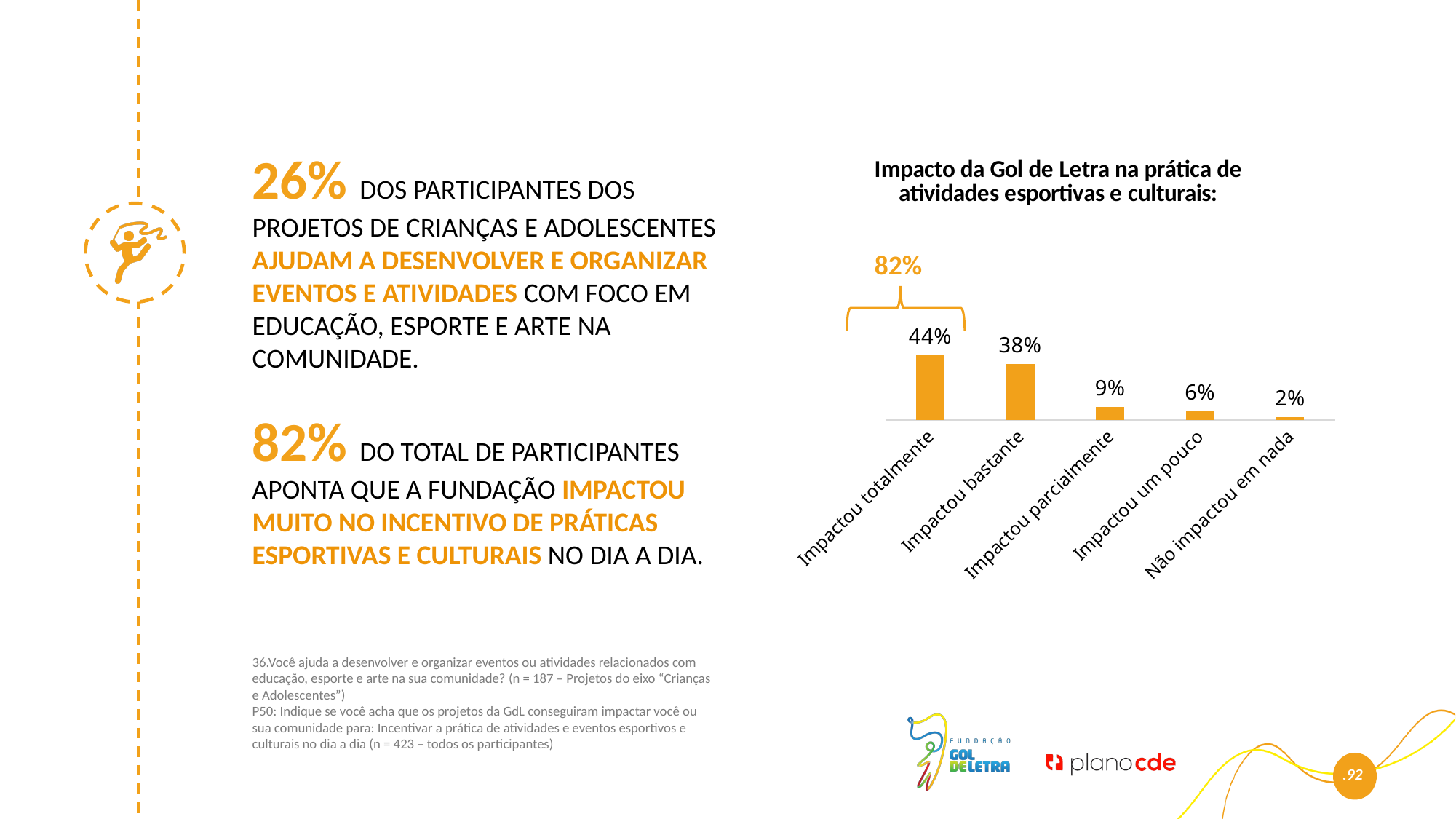
Do the values rise or fall from left to right along the x axis? Fall Which category has the lowest value? Não impactou em nada What is the title of the chart? Impacto da Gol de Letra na prática de atividades esportivas e culturais: What is the value for "Impactou totalmente"? 44% What is the difference between "Impactou totalmente" and "Impactou bastante"? 6% Which is larger, "Impactou parcialmente" or "Impactou um pouco"? Impactou parcialmente What is the value for "Impactou parcialmente"? 9% What kind of chart is shown? Bar chart What is the value for "Não impactou em nada"? 2% Which category has the highest value? Impactou totalmente What is the value for "Impactou bastante"? 38% How many categories are shown in the chart? 5